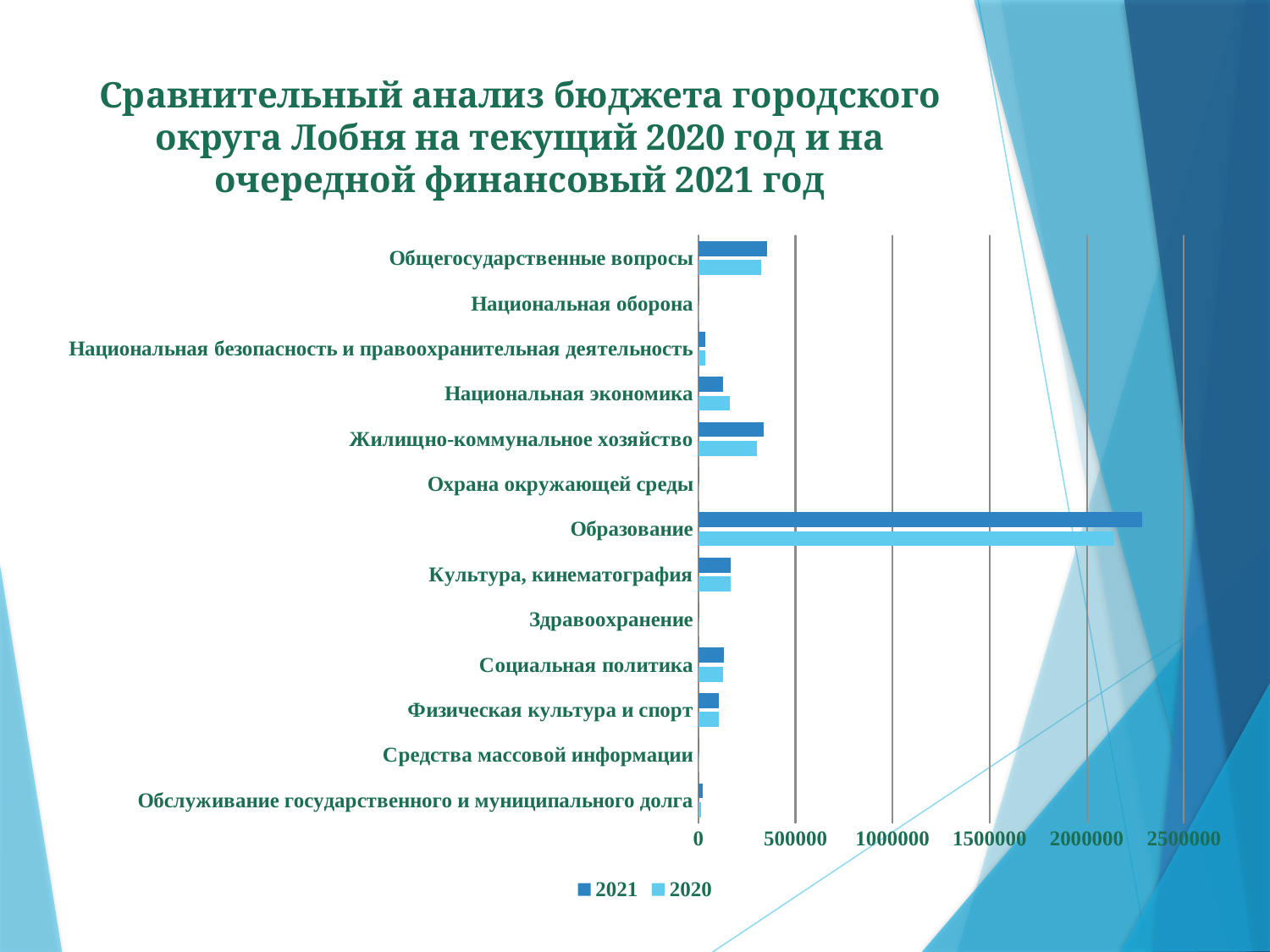
Which category has the highest value for 2020? Образование What kind of chart is shown on the slide? Bar chart Is the 2020 value for Жилищно-коммунальное хозяйство greater or less than 500000? less How many series does the legend list? 2 What are the two series named in the legend? 2021 and 2020 For Национальная экономика, which year has the larger value, 2021 or 2020? 2020 For Образование, which year has the larger value, 2021 or 2020? 2021 Is the 2021 value for Образование greater or less than 2000000? greater Is the 2021 value for Общегосударственные вопросы greater or less than 500000? less How many categories are shown on the vertical axis of the chart? 13 Which category has the highest value for 2021? Образование